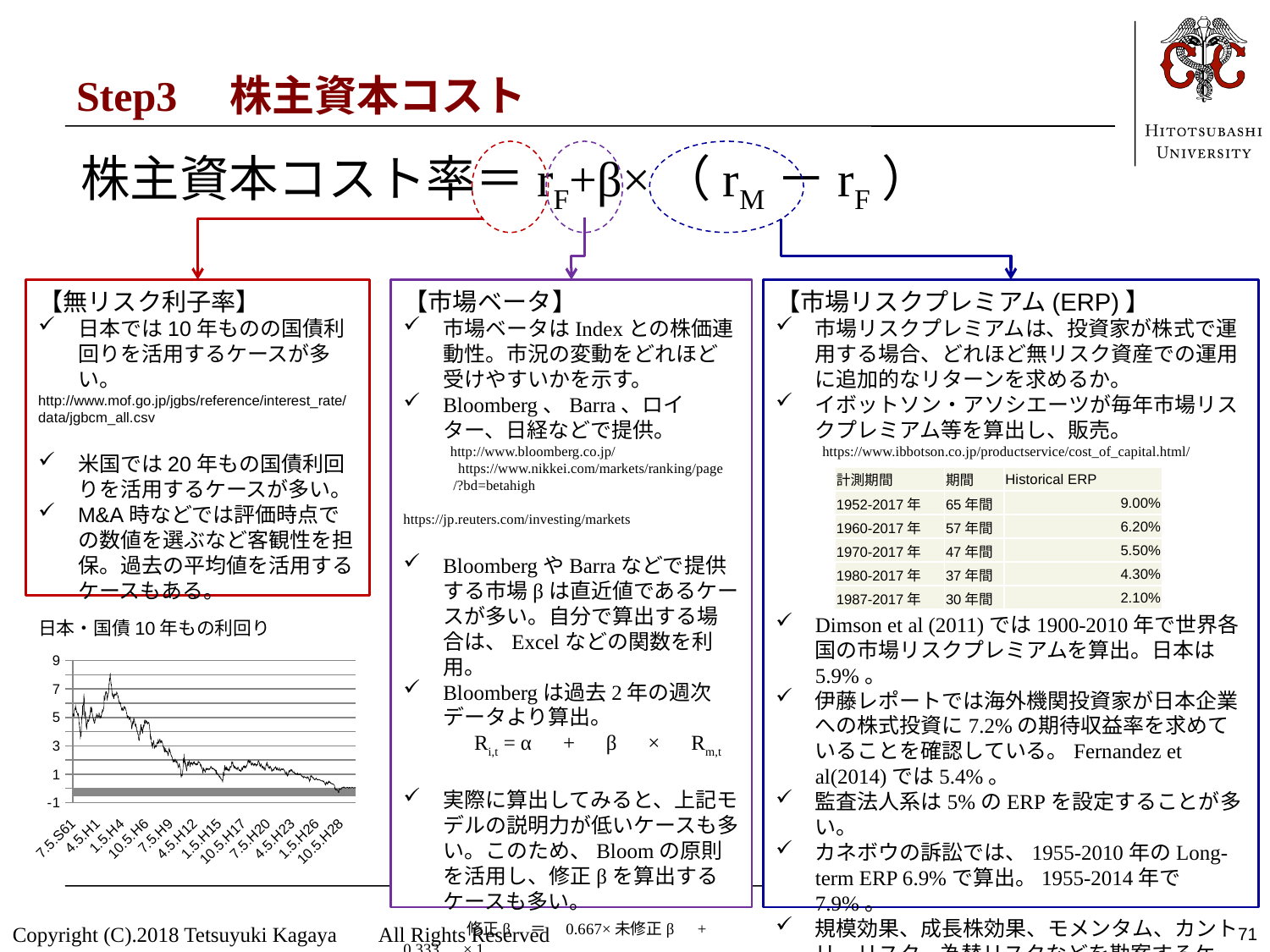
How many labels are shown on the x axis of the chart titled 日本・国債10年もの利回り? 12 What is the highest tick value shown on the y axis of the chart titled 日本・国債10年もの利回り? 9 In the chart titled 日本・国債10年もの利回り, is the value at 7.5.S61 greater or less than 3? greater What is the title of the chart at the bottom left of the slide? 日本・国債10年もの利回り In the chart titled 日本・国債10年もの利回り, which is larger, the value at 7.5.S61 or the value at 10.5.H28? 7.5.S61 What is the first label on the x axis of the chart titled 日本・国債10年もの利回り? 7.5.S61 In the chart titled 日本・国債10年もの利回り, is the value at 7.5.H20 greater or less than 3? less In the chart titled 日本・国債10年もの利回り, do the values generally rise or fall from left to right along the x axis? fall In the chart titled 日本・国債10年もの利回り, is the value at 1.5.H26 greater or less than 3? less What kind of chart is shown at the bottom left of the slide? line chart